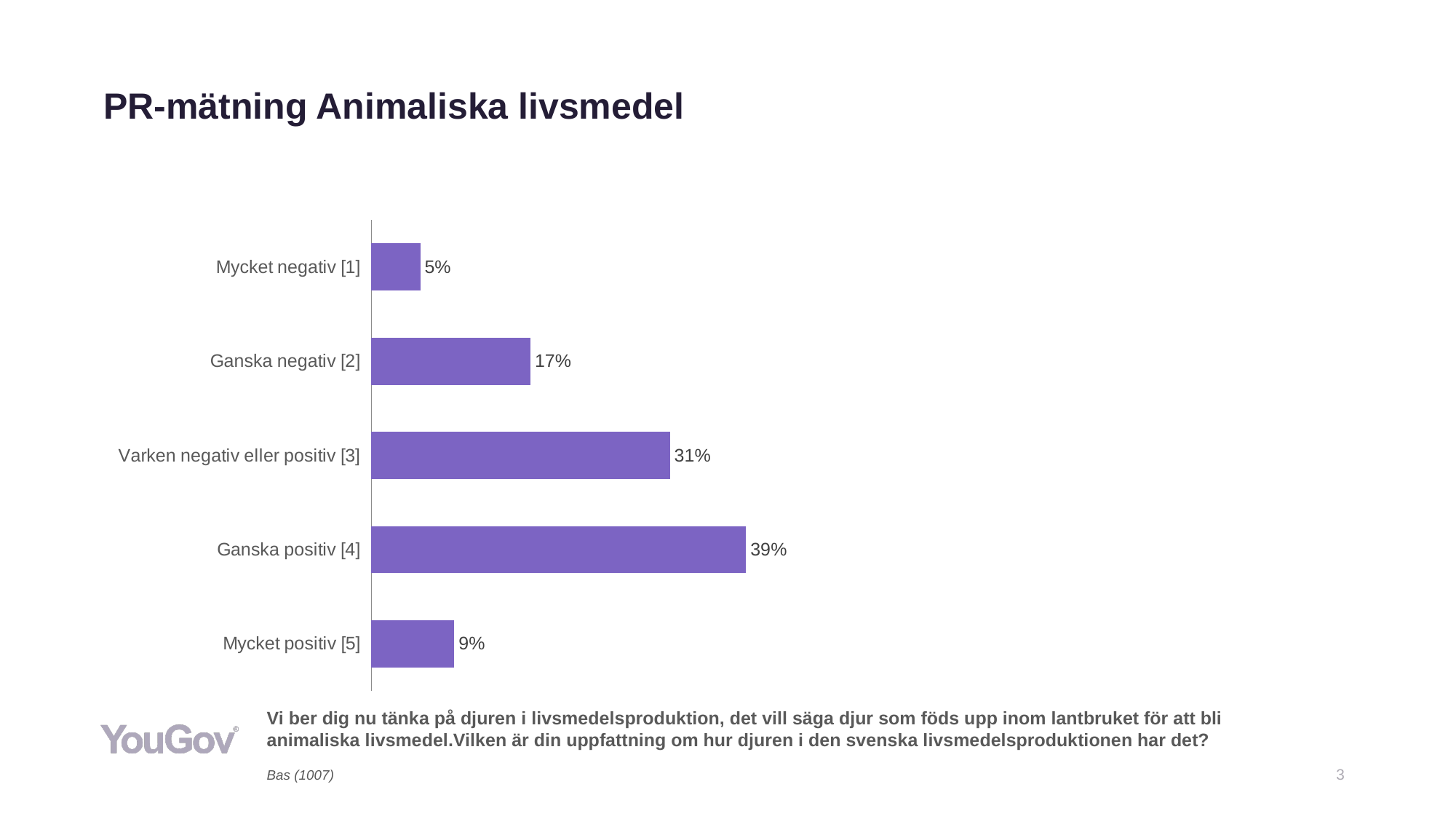
What is the title of the slide? PR-mätning Animaliska livsmedel What is the difference between Ganska positiv [4] and Ganska negativ [2]? 22% Which is larger, Ganska negativ [2] or Mycket positiv [5]? Ganska negativ [2] What is the difference between Varken negativ eller positiv [3] and Mycket positiv [5]? 22% Which category has the highest value? Ganska positiv [4] What is the value for Mycket positiv [5]? 9% Which category has the lowest value? Mycket negativ [1] How many categories are shown in the chart? 5 What kind of chart is shown on the slide? Bar chart What is the value for Mycket negativ [1]? 5% What is the value for Varken negativ eller positiv [3]? 31% What is the value for Ganska positiv [4]? 39%